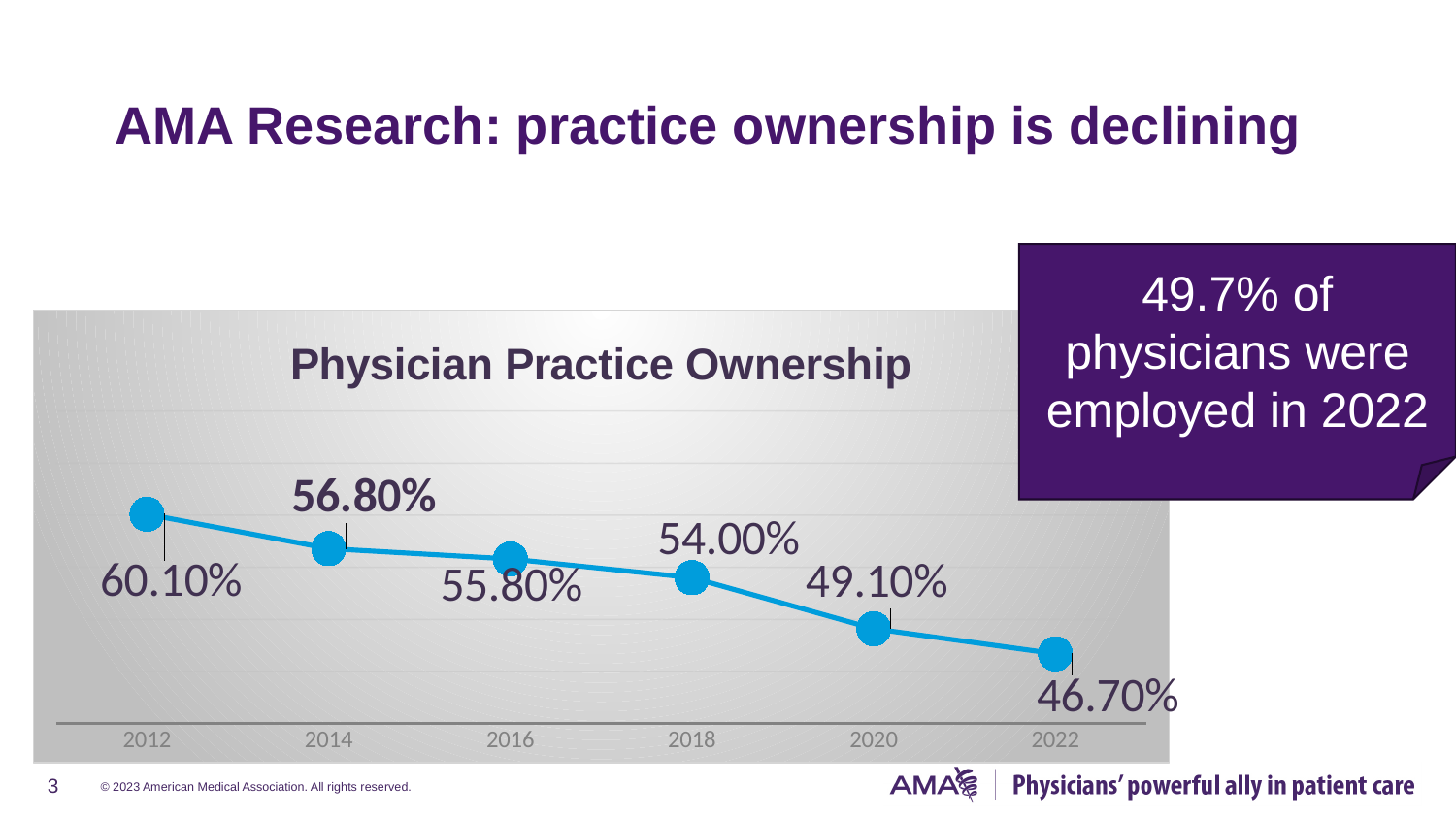
Which is larger, the value for 2014 or the value for 2018? 2014 What is the physician practice ownership value for 2022? 46.70% What kind of chart is shown on the slide? line chart What is the chart's title? Physician Practice Ownership What is the physician practice ownership value for 2016? 55.80% What is the difference between the 2012 and 2022 values? 13.40% Which year has the highest physician practice ownership value? 2012 What is the difference between the 2018 and 2020 values? 4.90% Do the values rise or fall from 2012 to 2022? fall Which year has the lowest physician practice ownership value? 2022 How many data points are plotted on the chart? 6 What is the physician practice ownership value for 2012? 60.10%